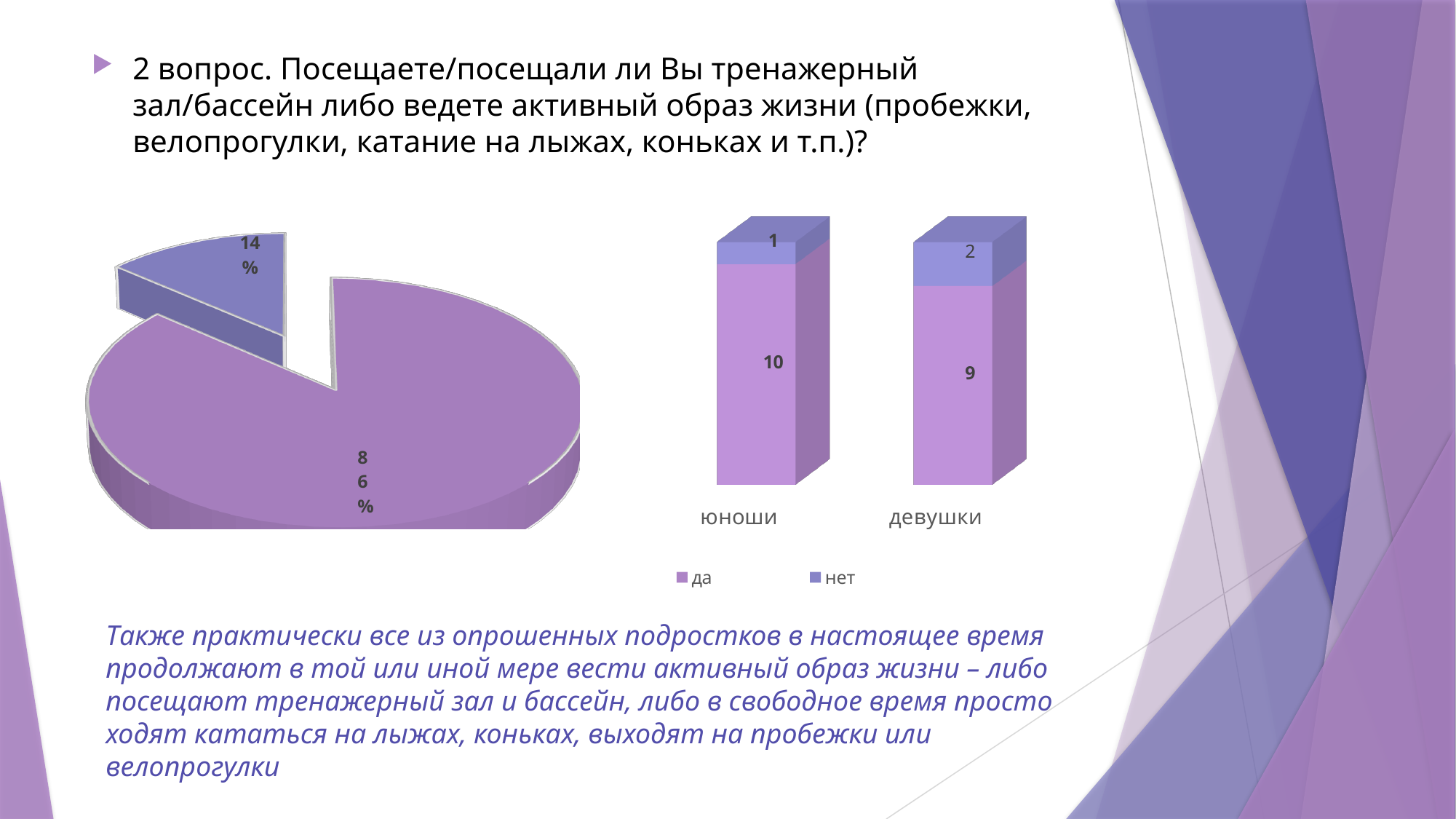
In the bar chart on the right, which category has the larger 'да' value, юноши or девушки? юноши What kind of chart is the chart on the left of the slide? pie chart What kind of chart is the chart on the right of the slide? stacked bar chart How many slices does the pie chart on the left have? 2 In the pie chart on the left, what percentage is shown on the smallest slice? 14% In the bar chart on the right, what is the value of 'да' for девушки? 9 In the bar chart on the right, what is the value of 'нет' for девушки? 2 How many series does the legend of the bar chart on the right list? 2 In the bar chart on the right, what is the total of the stacked bar for юноши? 11 In the bar chart on the right, what is the value of 'нет' for юноши? 1 In the bar chart on the right, what is the value of 'да' for юноши? 10 In the pie chart on the left, what percentage is shown on the largest slice? 86%